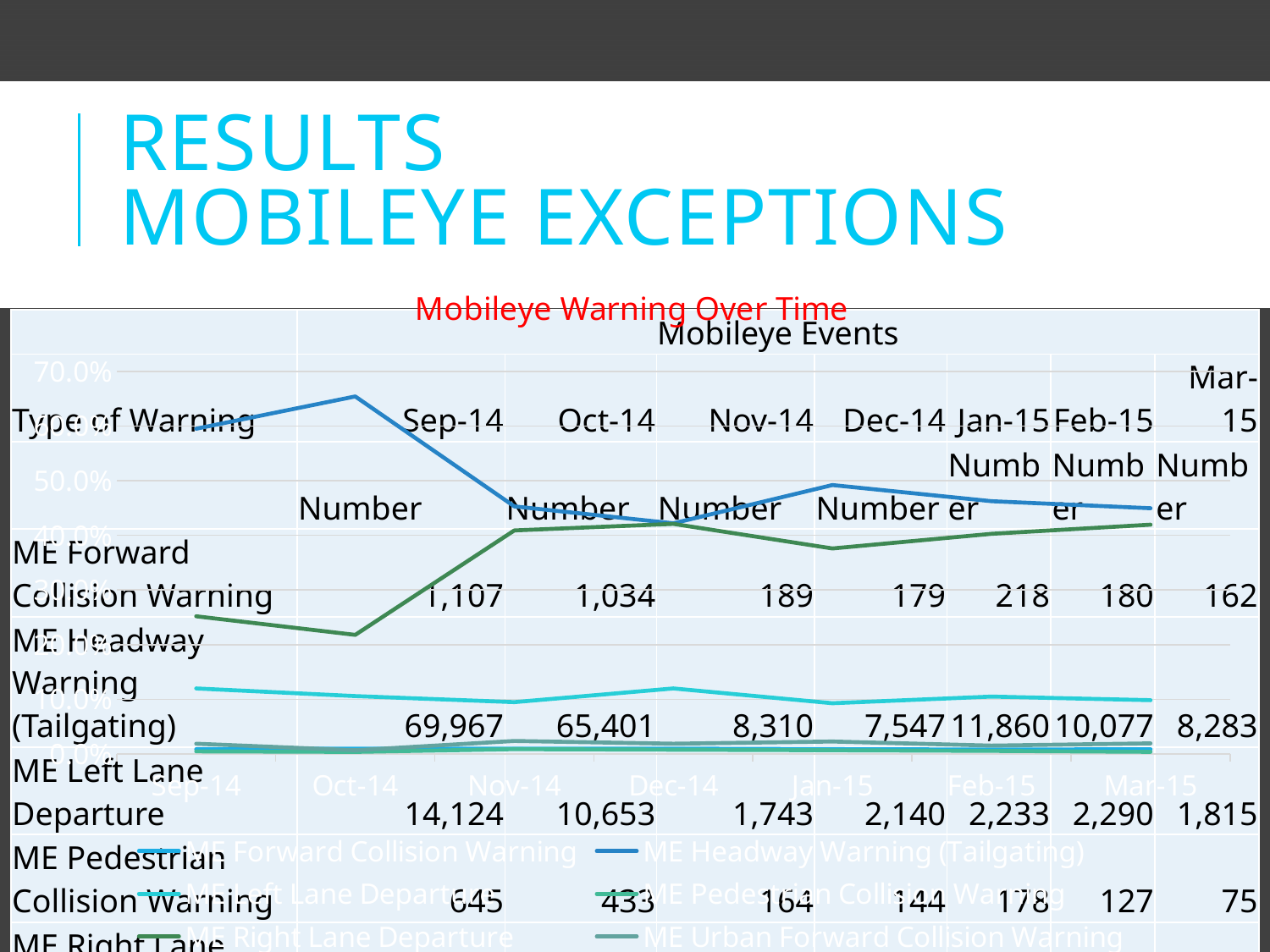
In the Mobileye Events table, what is the number of ME Forward Collision Warning events in Sep-14? 1,107 In the Mobileye Warning Over Time chart, is the value for ME Headway Warning (Tailgating) at Mar-15 greater or less than 50%? less In the Mobileye Warning Over Time chart, is the value for ME Headway Warning (Tailgating) at Oct-14 greater or less than 50%? greater In the Mobileye Warning Over Time chart, does the ME Headway Warning (Tailgating) line rise or fall from Oct-14 to Nov-14? fall What kind of chart is the Mobileye Warning Over Time chart? line chart What is the title of the chart on the slide? Mobileye Warning Over Time How many months are shown along the x axis of the Mobileye Warning Over Time chart? 7 In the Mobileye Events table, what is the difference between ME Pedestrian Collision Warning events in Sep-14 and Mar-15? 570 How many series does the legend of the Mobileye Warning Over Time chart list? 6 What is the highest value shown on the y axis of the Mobileye Warning Over Time chart? 70.0% In the Mobileye Events table, what is the number of ME Headway Warning (Tailgating) events in Jan-15? 11,860 In the Mobileye Events table, which month has the highest number of ME Left Lane Departure events? Sep-14